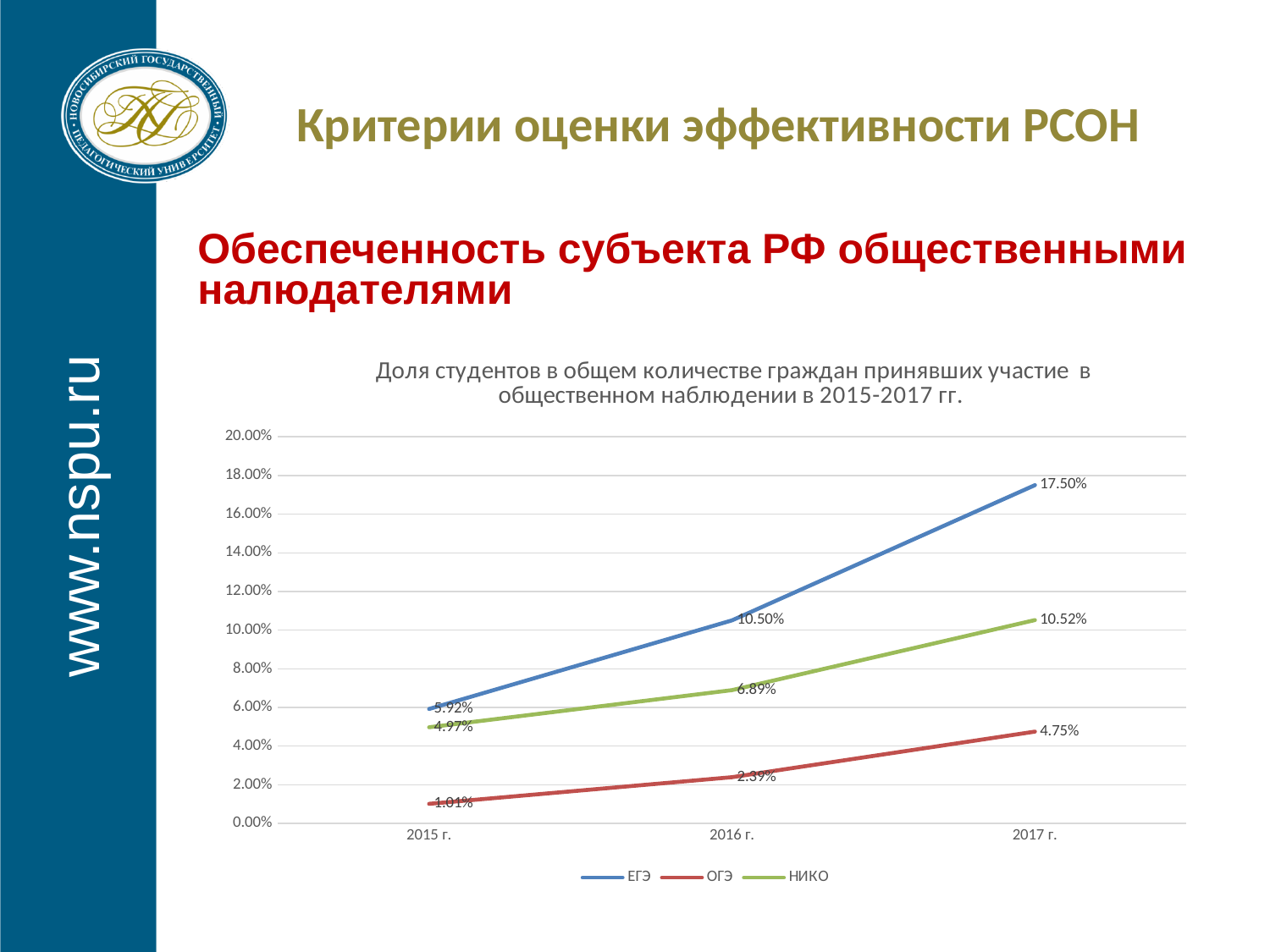
How many years are shown on the x axis? 3 What is the value for ЕГЭ in 2017 г.? 17.50% What type of chart is shown on the slide? line chart How many series does the legend list? 3 What is the value for ЕГЭ in 2015 г.? 5.92% Which series has the highest value in 2017 г.? ЕГЭ What is the value for НИКО in 2016 г.? 6.89% Which is larger in 2016 г.: the value for ЕГЭ or the value for НИКО? ЕГЭ What is the difference between the ЕГЭ values in 2017 г. and 2016 г.? 7.00% What is the value for ОГЭ in 2017 г.? 4.75% Which series has the lowest value in 2015 г.? ОГЭ Does the value for ОГЭ rise or fall from 2015 г. to 2017 г.? rise